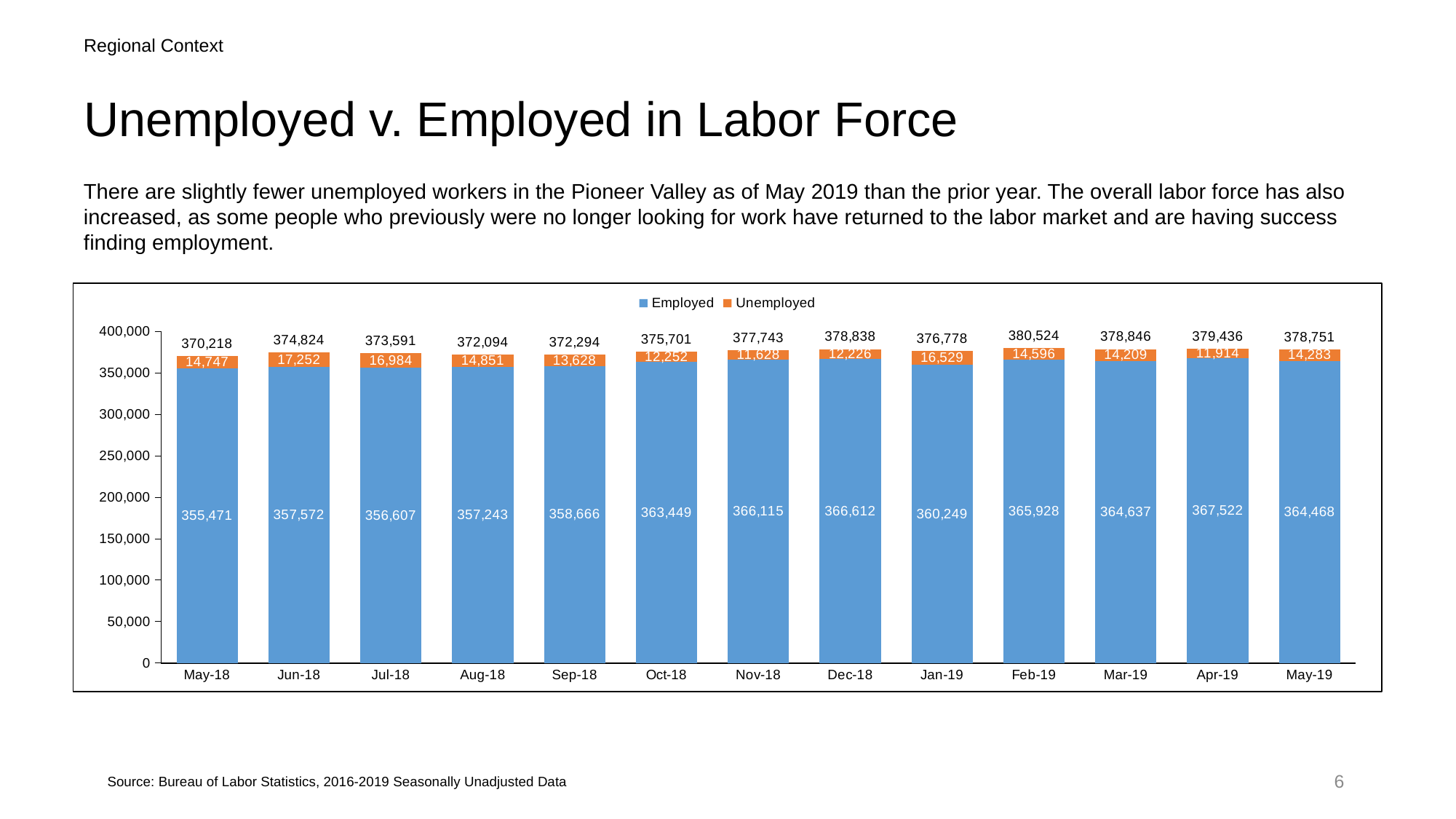
How many series does the legend list? 2 Which month has the lowest Unemployed value? Nov-18 Which is larger, the Employed value for Dec-18 or for Jan-19? Dec-18 Which month has the highest Employed value? Apr-19 How many months are shown on the x axis? 13 Which colour represents the Unemployed series? Orange Which month has the highest Unemployed value? Jun-18 What is the Unemployed value for Jan-19? 16,529 What is the difference between the Unemployed value in May-18 and in May-19? 464 What kind of chart is shown on the slide? Stacked bar chart What is the total labor force (stacked bar total) for Feb-19? 380,524 What is the Employed value for Oct-18? 363,449